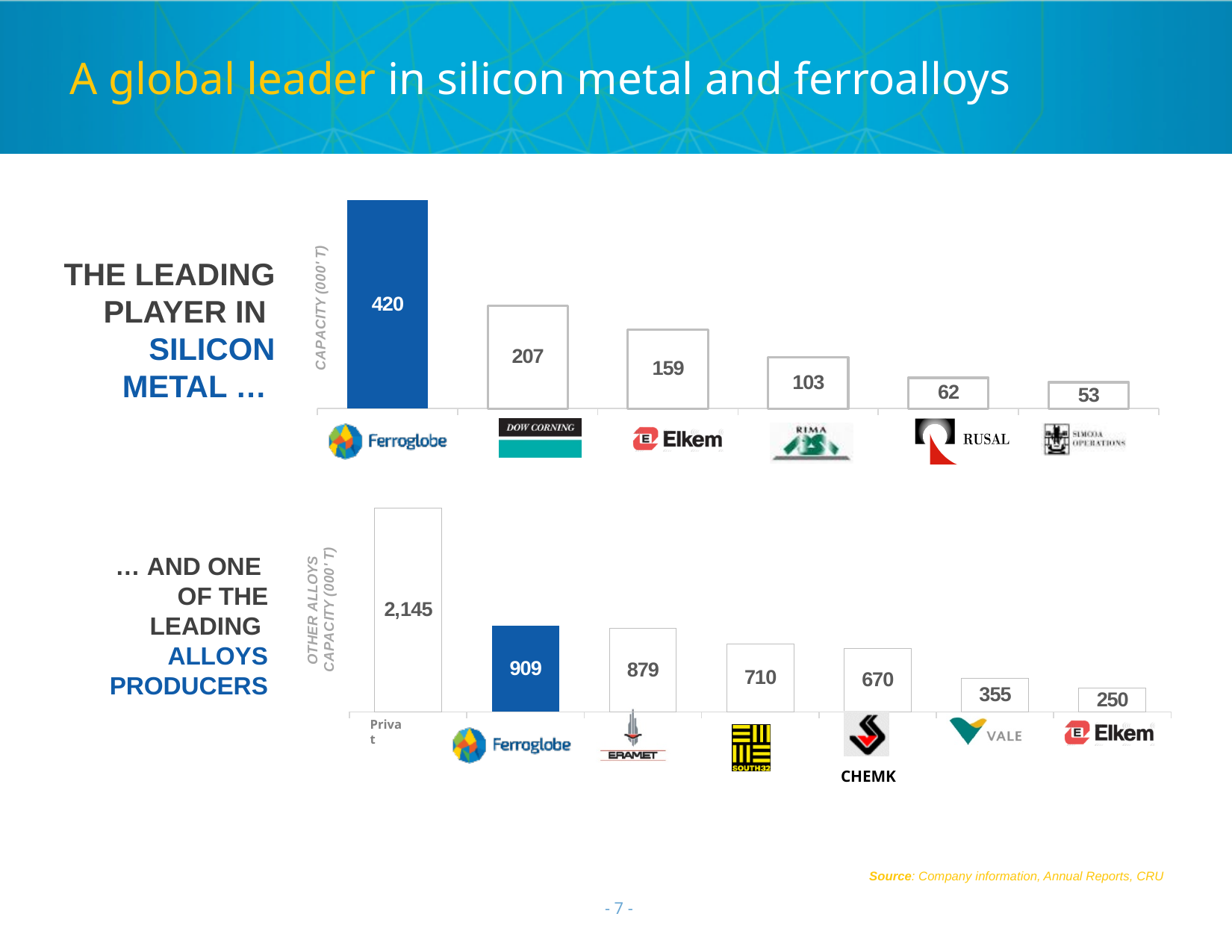
In the bottom chart (other alloys capacity), what is the difference between Ferroglobe and Eramet? 30 In the top chart (silicon metal capacity), which company has the lowest capacity? Simcoa Operations In the bottom chart (other alloys capacity), what is the value for Privat? 2,145 In the top chart (silicon metal capacity), what is the difference between Ferroglobe and Dow Corning? 213 In the bottom chart (other alloys capacity), which company has the highest capacity? Privat In the bottom chart (other alloys capacity), what is the value for Ferroglobe? 909 What type of chart is the bottom chart (other alloys capacity)? bar chart In the top chart (silicon metal capacity), what is the value for Elkem? 159 In the top chart (silicon metal capacity), how many companies are shown? 6 In the bottom chart (other alloys capacity), which is larger, Vale or Elkem? Vale In the top chart (silicon metal capacity), do the values rise or fall from left to right? fall In the top chart (silicon metal capacity), what is the value for Ferroglobe? 420